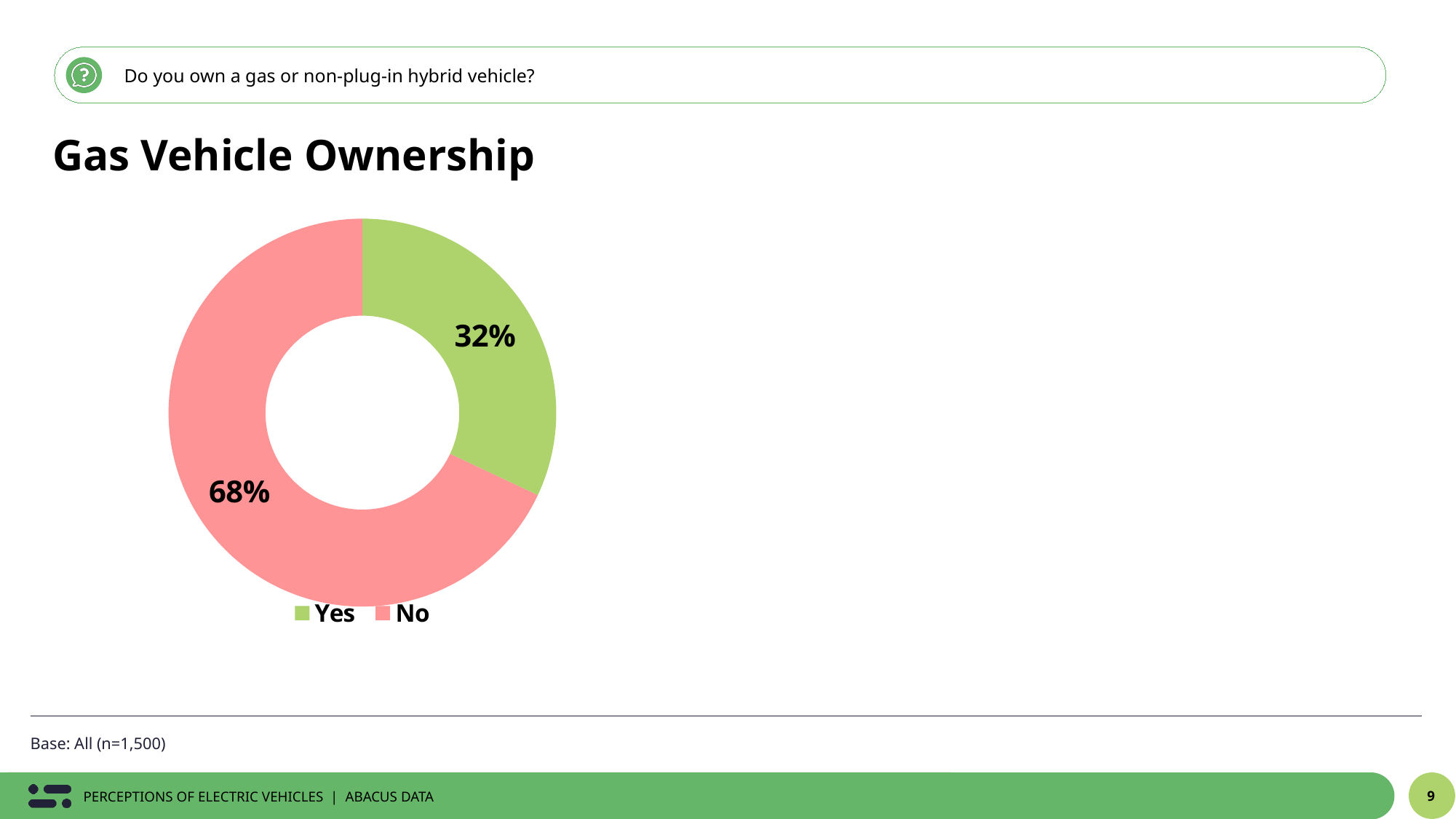
What kind of chart is shown on the slide? Doughnut (pie) chart Which colour represents the Yes response in the chart? Green What share of the chart does the No slice represent? 68% Is the share for Yes larger or smaller than the share for No? smaller Which response has the smaller share of the chart? Yes How many entries does the legend list? 2 What percentage of respondents answered No to owning a gas or non-plug-in hybrid vehicle? 68% How many categories are shown in the chart? 2 What is the difference in percentage points between the No and Yes shares? 36 Which response has the larger share of the chart, Yes or No? No What is the title of the chart on the slide? Gas Vehicle Ownership What percentage of respondents answered Yes to owning a gas or non-plug-in hybrid vehicle? 32%